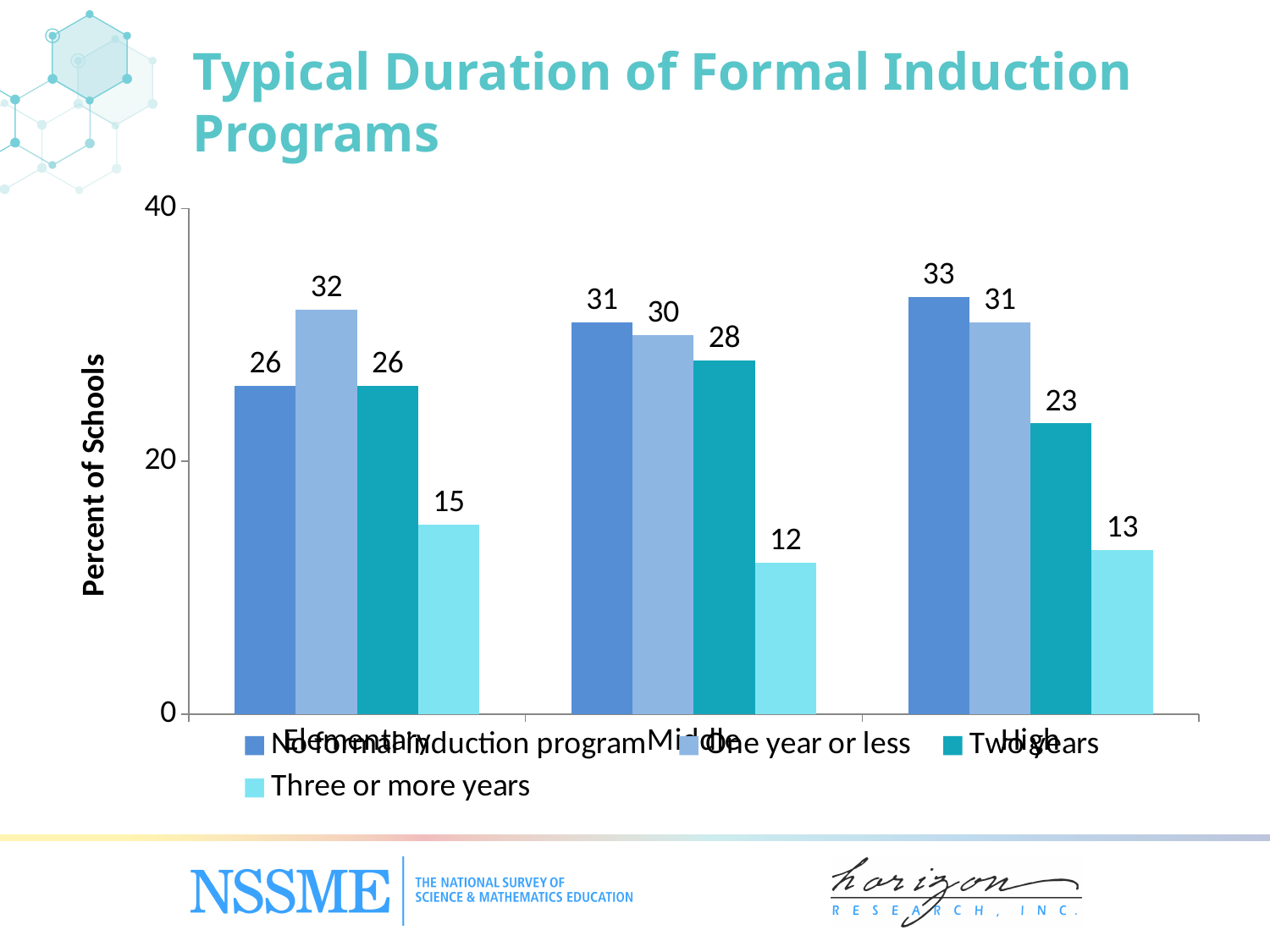
What is the value for 'No formal induction program' in the High group? 33 Which series has the lowest value in the High group? Three or more years What is the difference between the 'Two years' values for the Middle and High groups? 5 What type of chart is shown on the slide? Bar chart How many school-level groups are shown on the x axis? 3 How many series does the legend list? 4 What is the value for 'One year or less' in the Elementary group? 32 Which series has the highest value in the Elementary group? One year or less What is the value for 'Three or more years' in the Middle group? 12 What is the title of the chart? Typical Duration of Formal Induction Programs What is the label of the y axis? Percent of Schools Which is larger: 'Three or more years' for Elementary or 'Three or more years' for High? Elementary